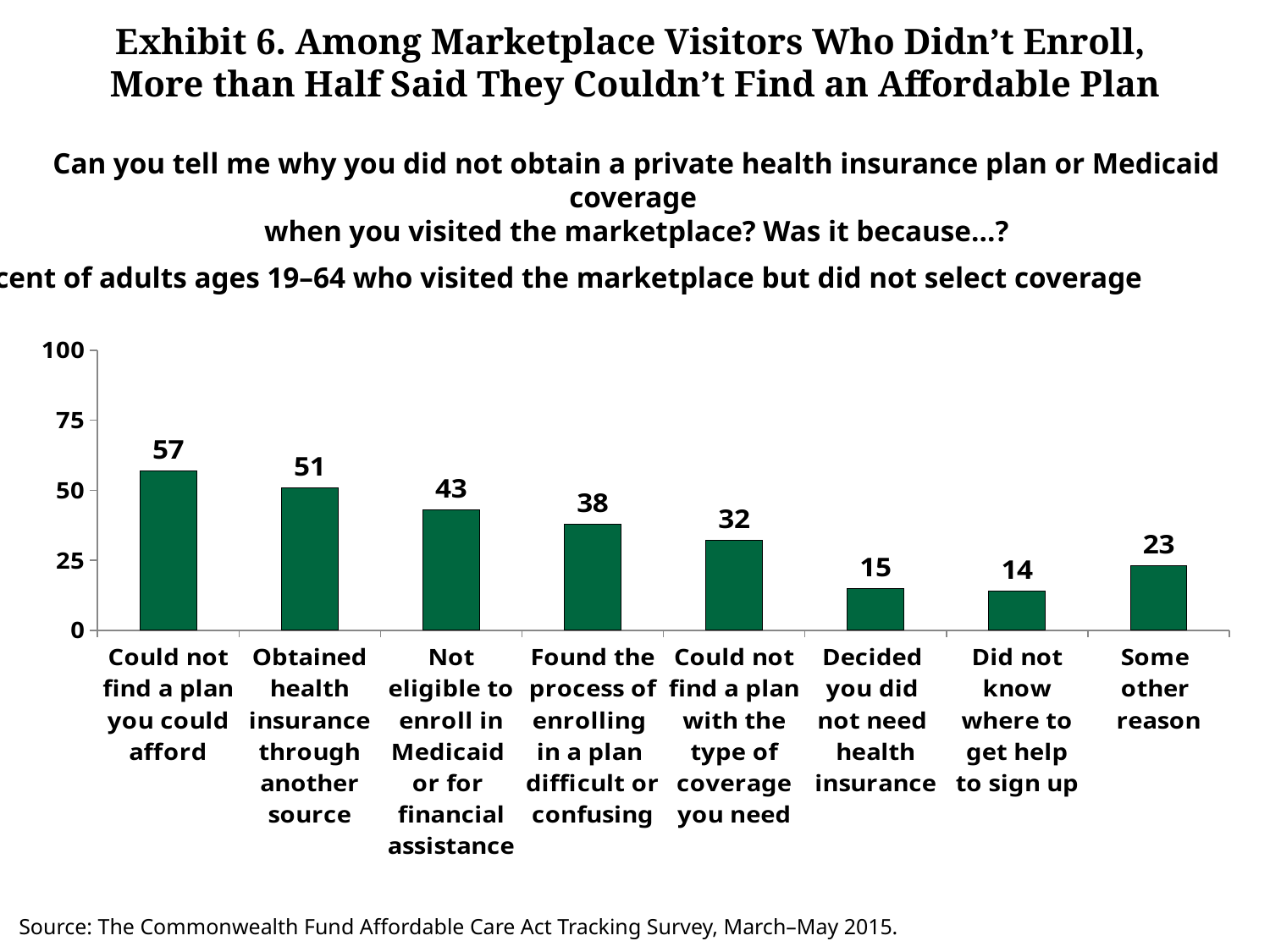
Is the value for "Could not find a plan with the type of coverage you need" greater or less than 25? greater What is the difference between the values for "Found the process of enrolling in a plan difficult or confusing" and "Could not find a plan with the type of coverage you need"? 6 Which is larger: the value for "Some other reason" or the value for "Decided you did not need health insurance"? Some other reason Which category has the highest value? Could not find a plan you could afford Which category has the lowest value? Did not know where to get help to sign up What kind of chart is shown on the slide? Bar chart What is the difference between the values for "Could not find a plan you could afford" and "Obtained health insurance through another source"? 6 What is the value for "Could not find a plan you could afford"? 57 What is the maximum value shown on the vertical axis? 100 How many categories are shown in the chart? 8 What is the value for "Some other reason"? 23 What is the value for "Not eligible to enroll in Medicaid or for financial assistance"? 43